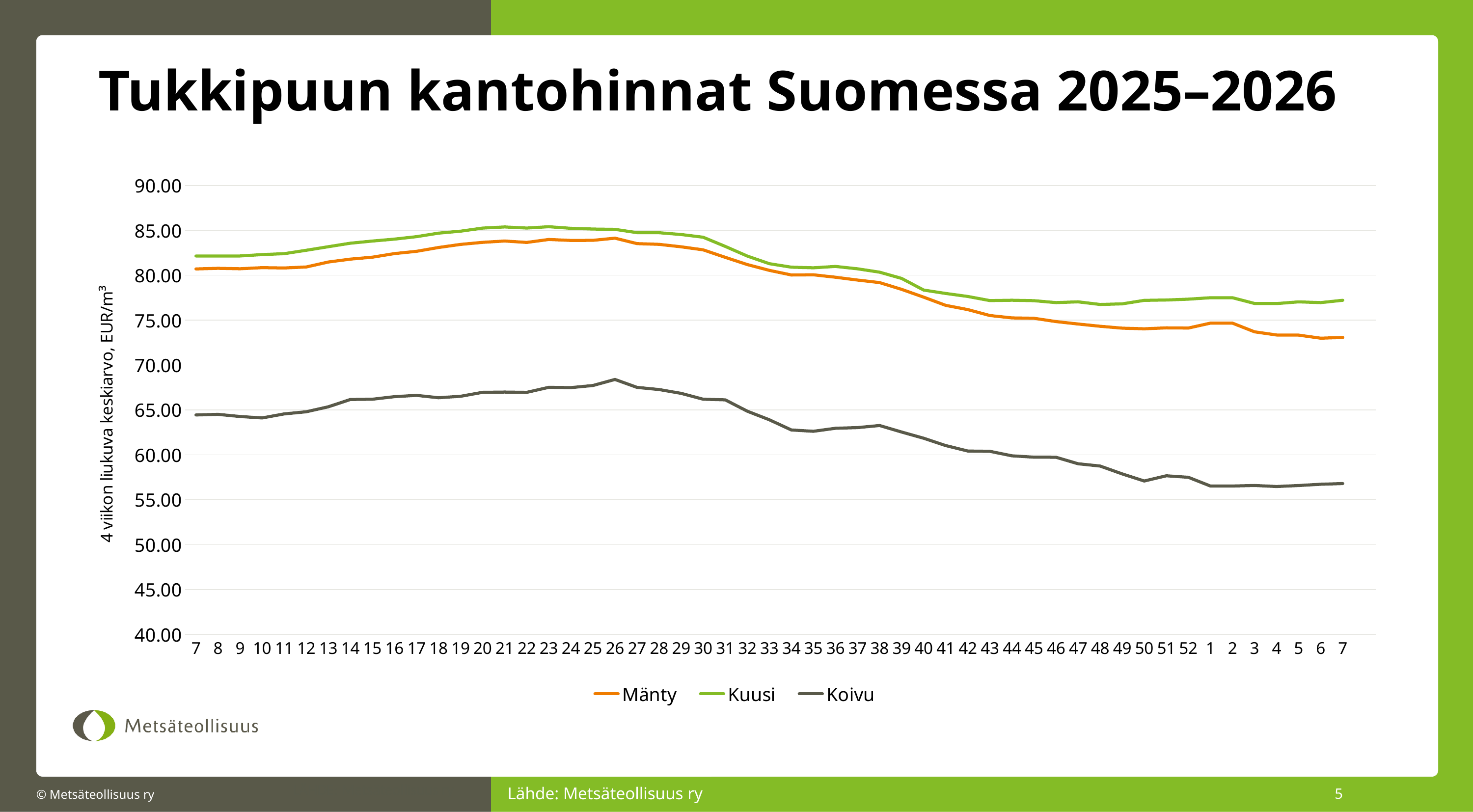
Is the value for Mänty at the last week 7 (end of the x axis) greater or less than 75? less At week 20, which is higher, Kuusi or Mänty? Kuusi What kind of chart is shown on the slide? line chart Is the value for Koivu at week 26 greater or less than 65? greater Is the value for Mänty at the first week 7 (start of the x axis) greater or less than 80? greater How many series does the legend list? 3 What is the y-axis label of the chart? 4 viikon liukuva keskiarvo, EUR/m³ Which series has the lowest values throughout the chart? Koivu Which series has the highest values throughout the chart? Kuusi Does the Koivu line rise or fall from week 26 to week 1? fall